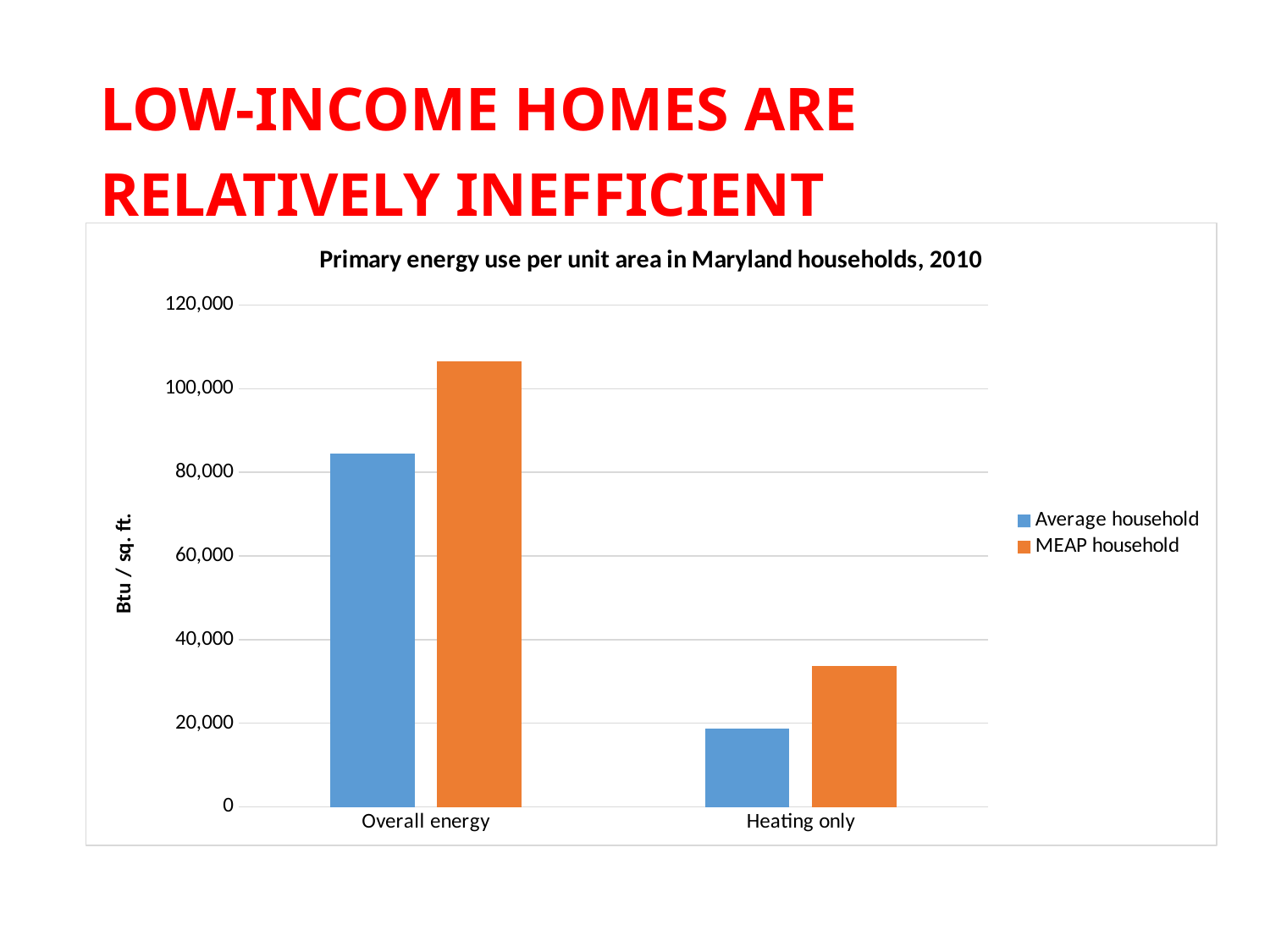
Is the value for MEAP household in Overall energy greater or less than 100,000? greater Is the value for MEAP household in Heating only greater or less than 40,000? less What kind of chart is shown on the slide? bar chart Which series has the larger value for Overall energy, Average household or MEAP household? MEAP household What is the label of the vertical axis? Btu / sq. ft. How many series does the legend list? 2 Which bar is the tallest in the chart? MEAP household, Overall energy How many categories are shown on the x axis? 2 Is the value for Average household in Heating only greater or less than 20,000? less What is the title of the chart? Primary energy use per unit area in Maryland households, 2010 Which bar is the shortest in the chart? Average household, Heating only